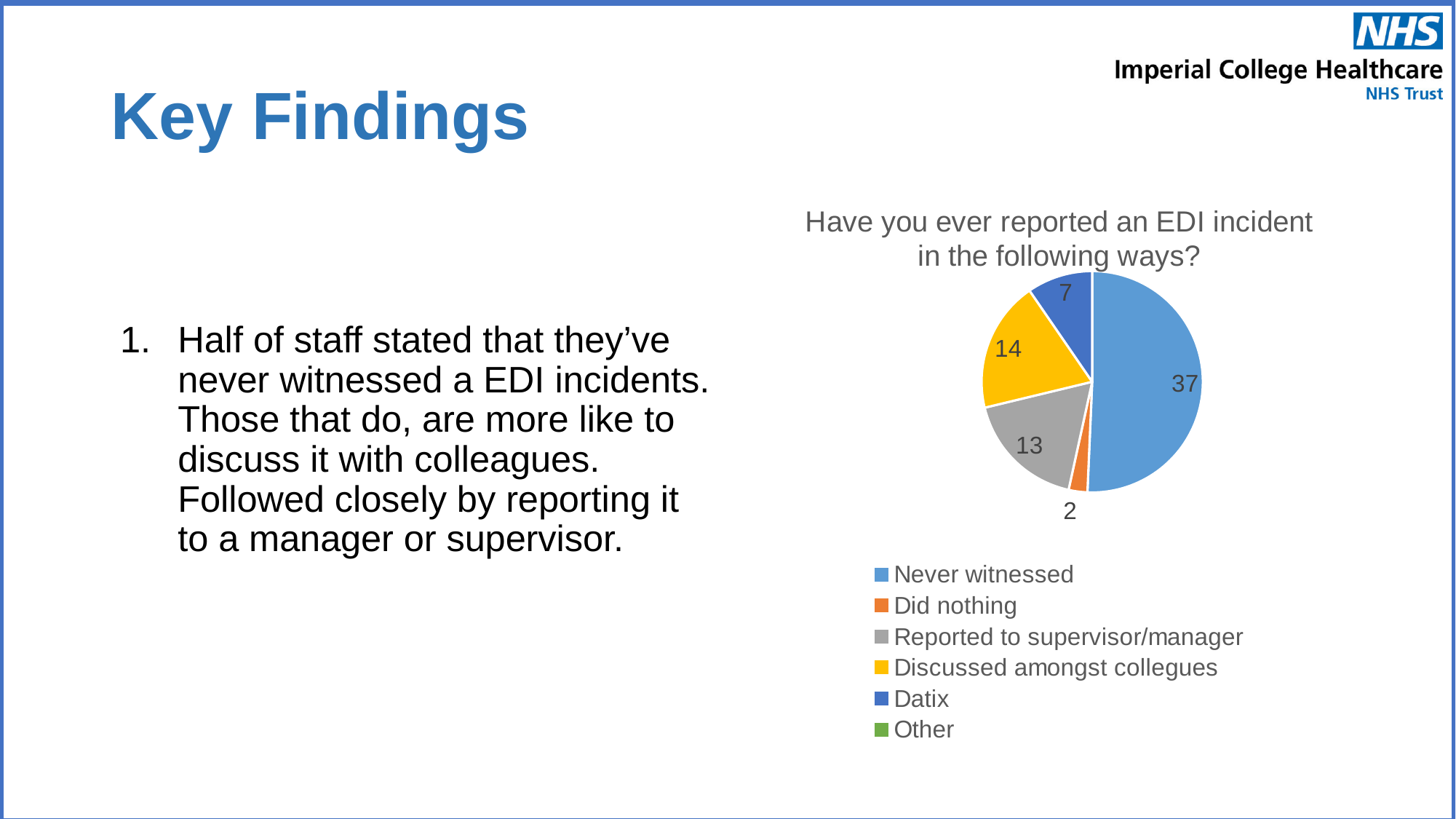
What is the value for Never witnessed in the pie chart? 37 How many categories does the legend of the pie chart list? 6 What is the title of the pie chart? Have you ever reported an EDI incident in the following ways? Which labelled category has the smallest slice in the pie chart? Did nothing Which category has the largest slice in the pie chart? Never witnessed What is the difference between the values for Never witnessed and Discussed amongst collegues? 23 What is the value for Reported to supervisor/manager in the pie chart? 13 What is the value for Discussed amongst collegues in the pie chart? 14 What type of chart is shown on the slide? Pie chart What is the value for Did nothing in the pie chart? 2 What is the value for Datix in the pie chart? 7 Which is larger, the value for Reported to supervisor/manager or the value for Datix? Reported to supervisor/manager